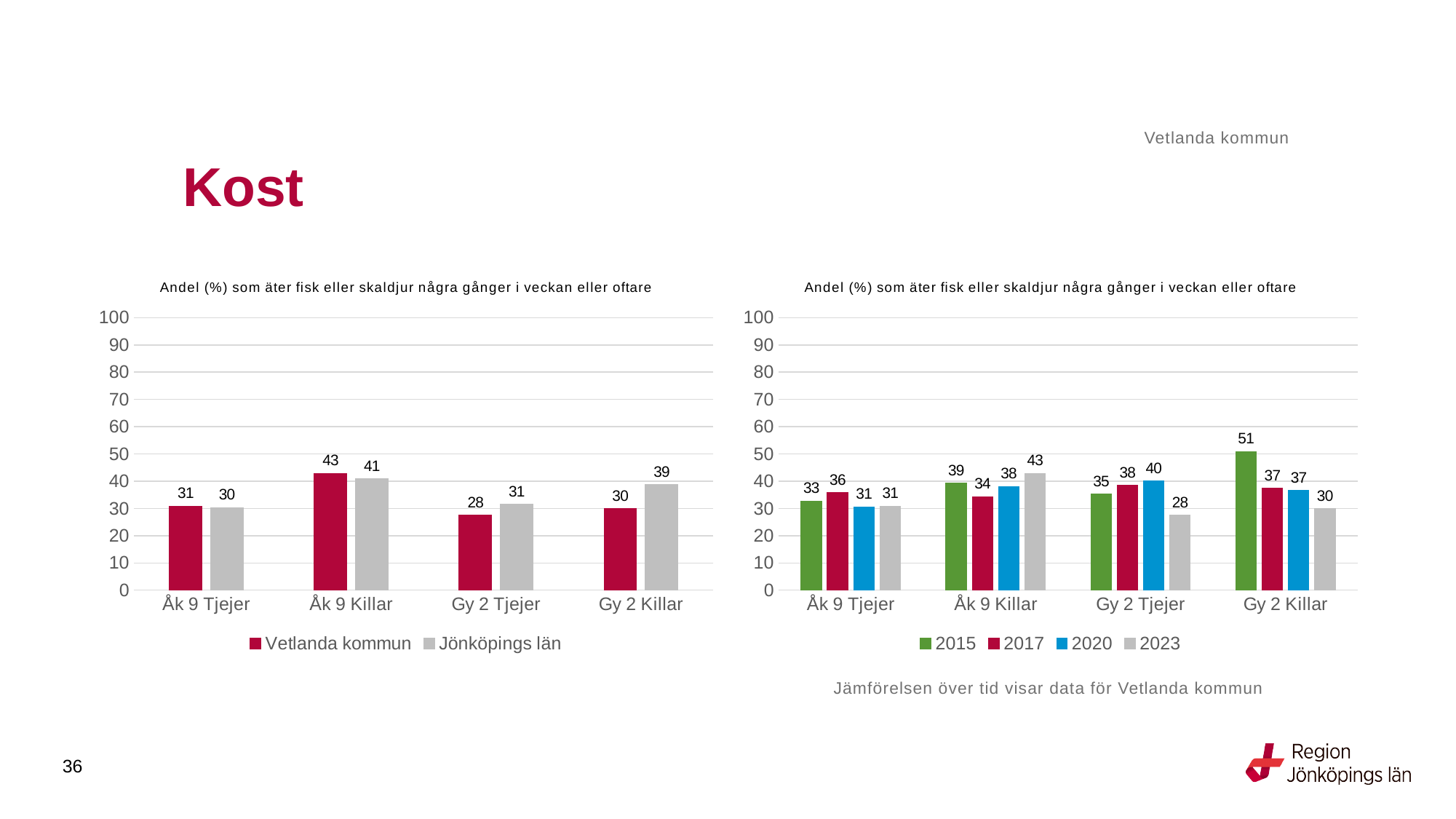
What kind of chart is the right chart? bar chart In the left chart, what is the value for Vetlanda kommun for Åk 9 Killar? 43 In the left chart, which category has the highest value for Vetlanda kommun? Åk 9 Killar In the left chart, what is the difference between Jönköpings län and Vetlanda kommun for Gy 2 Killar? 9 In the right chart, what is the value for 2023 for Gy 2 Tjejer? 28 In the right chart, which year has the highest value for Åk 9 Killar? 2023 In the left chart, which category has the lowest value for Jönköpings län? Åk 9 Tjejer In the left chart, how many series does the legend list? 2 In the right chart, what is the value for 2015 for Gy 2 Killar? 51 In the right chart, is the 2015 value for Gy 2 Killar larger or smaller than the 2023 value for Gy 2 Killar? larger In the right chart, how many series does the legend list? 4 In the left chart, what is the value for Jönköpings län for Gy 2 Killar? 39